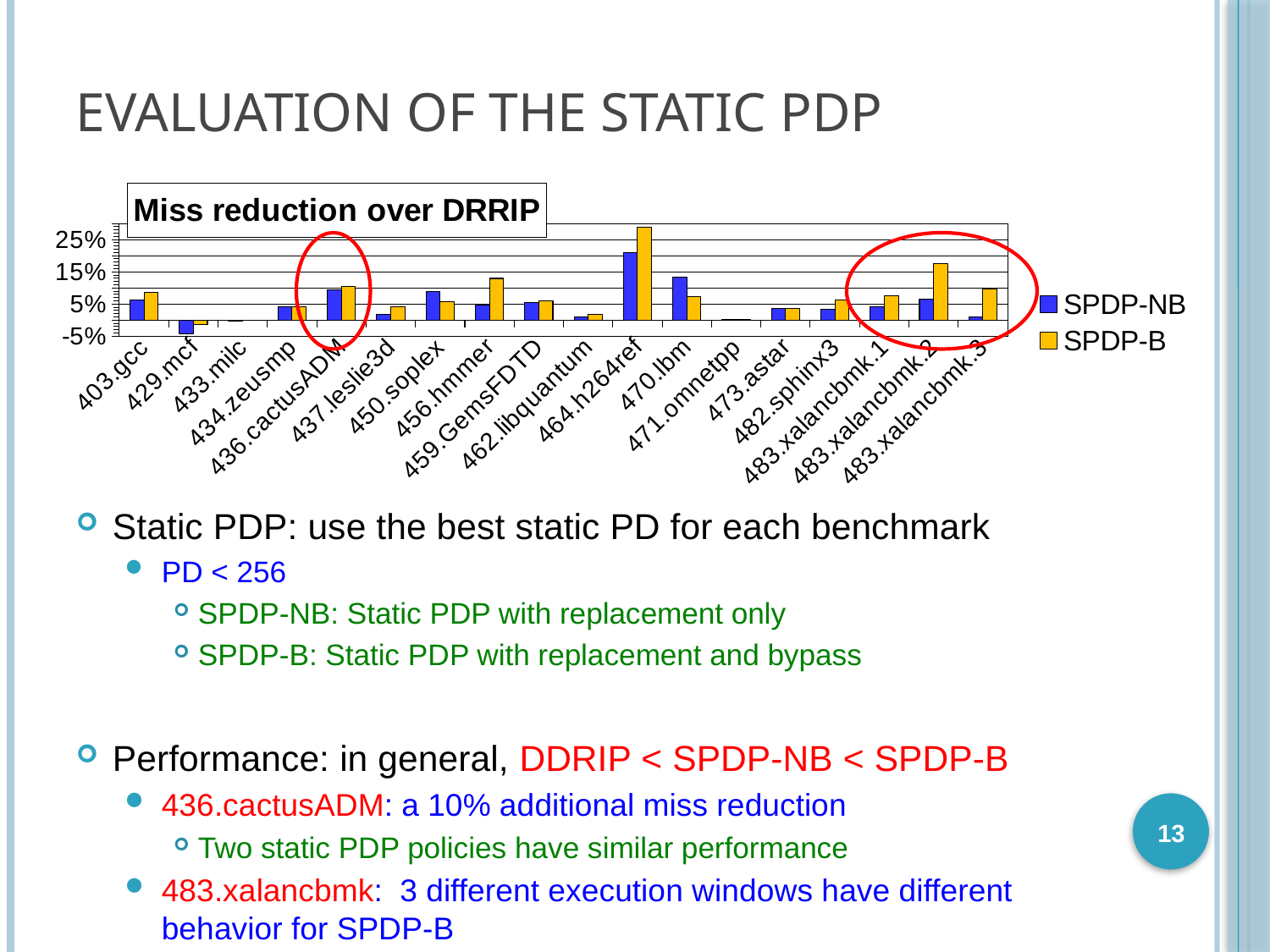
What kind of chart is shown on the slide? Bar chart Is the SPDP-NB value for 464.h264ref greater or less than 15%? greater Which benchmark has the highest SPDP-B miss reduction in the chart? 464.h264ref Which is larger, the SPDP-B value for 464.h264ref or the SPDP-B value for 470.lbm? 464.h264ref Is the SPDP-NB value for 429.mcf greater or less than 5%? less How many series does the chart legend list? 2 Which benchmark has the highest SPDP-NB miss reduction in the chart? 464.h264ref Which series is drawn in blue in the chart? SPDP-NB Is the SPDP-B value for 464.h264ref greater or less than 25%? greater What is the title of the chart? Miss reduction over DRRIP How many benchmark categories are plotted along the x axis of the chart? 18 Which is larger for 483.xalancbmk.2, the SPDP-NB value or the SPDP-B value? SPDP-B